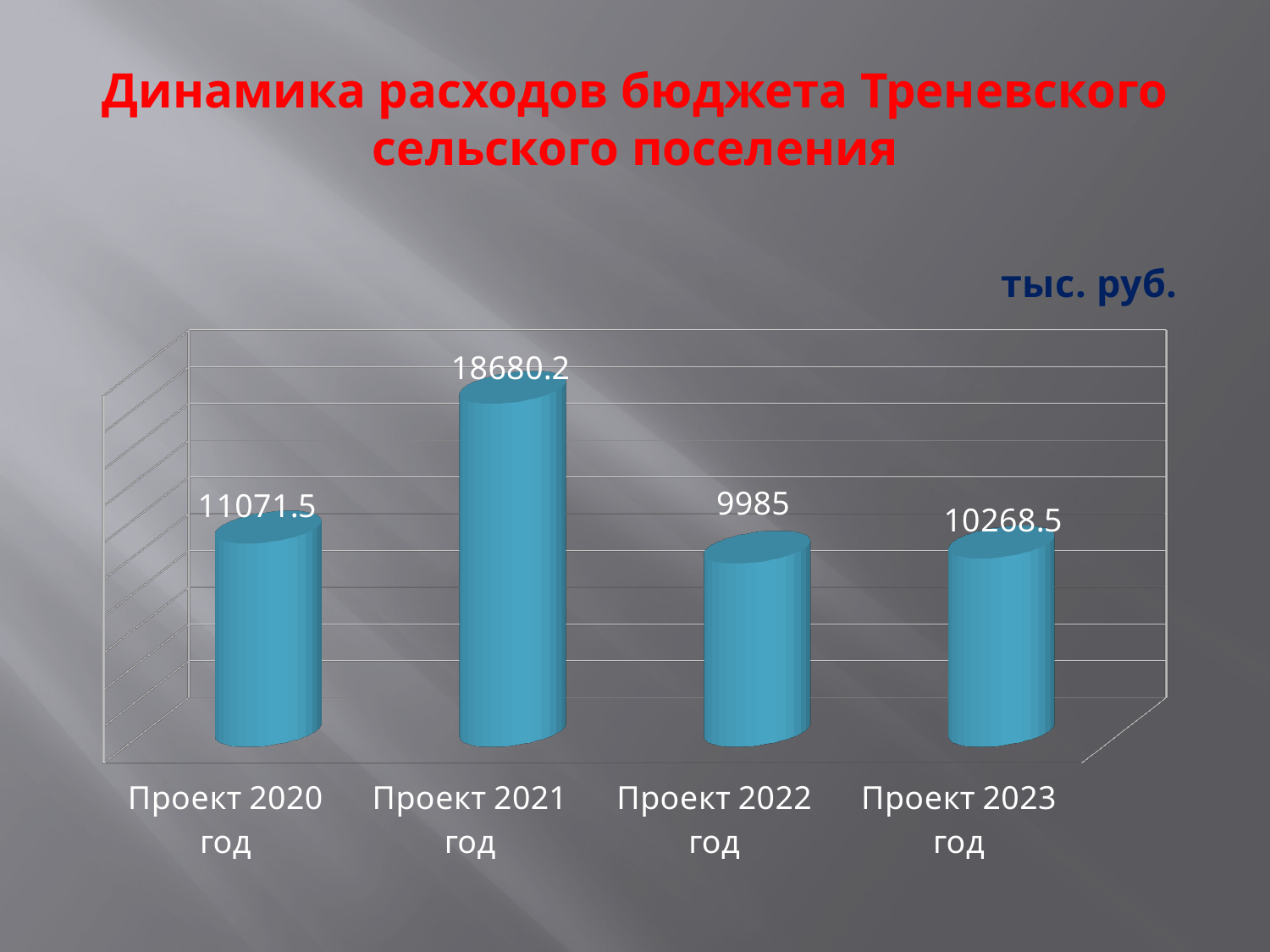
How many categories are shown in the chart? 4 Which is larger, the value for Проект 2020 год or Проект 2023 год? Проект 2020 год What is the value for Проект 2021 год? 18680.2 What is the difference between the values for Проект 2021 год and Проект 2020 год? 7608.7 What kind of chart is shown on the slide? bar chart What is the value for Проект 2020 год? 11071.5 Which category has the lowest value? Проект 2022 год What is the difference between the values for Проект 2023 год and Проект 2022 год? 283.5 What is the value for Проект 2023 год? 10268.5 What is the value for Проект 2022 год? 9985 Which category has the highest value? Проект 2021 год In what units are the values on the chart expressed? тыс. руб.